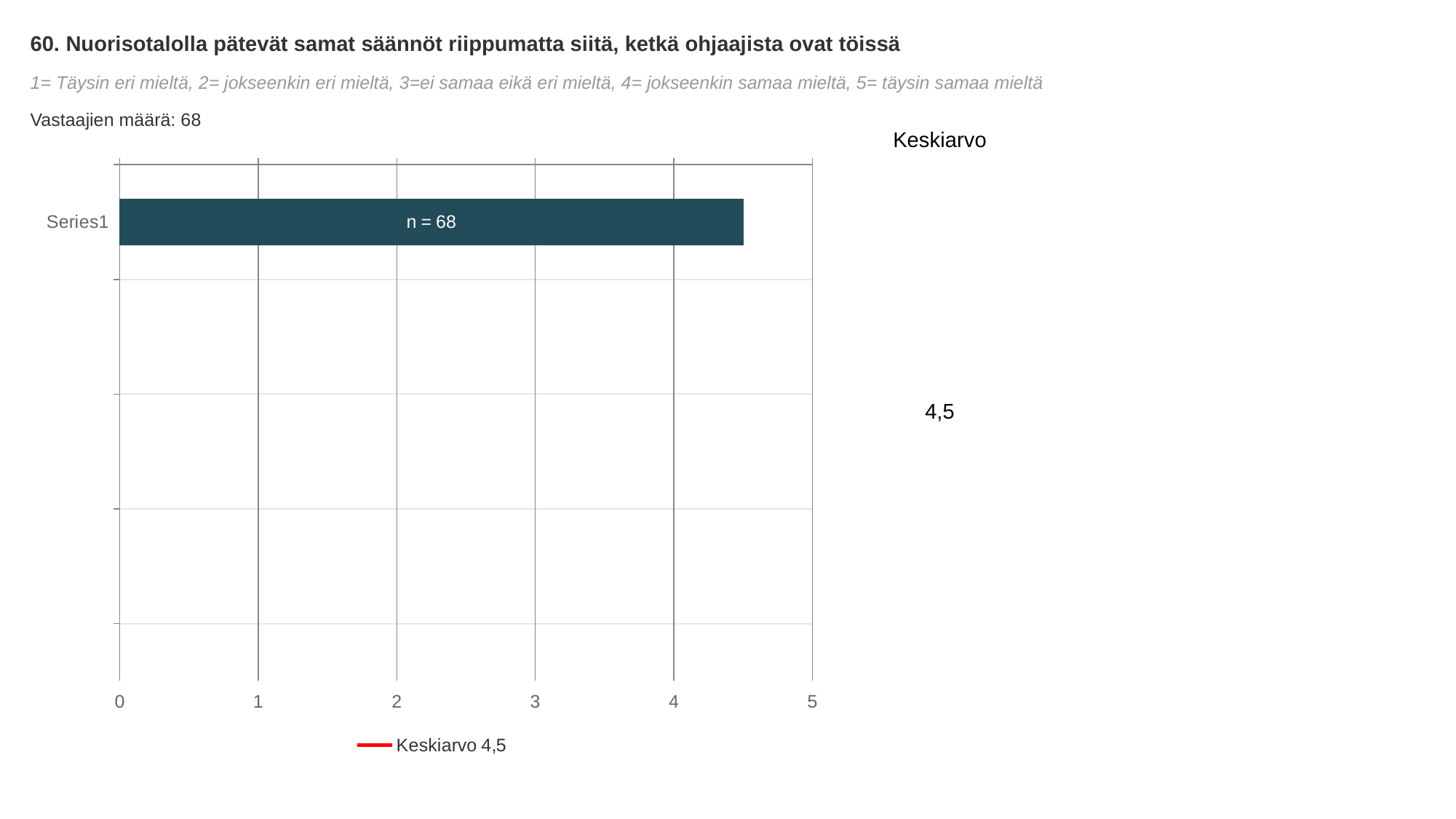
Is the value of the Series1 bar greater or less than 4? greater What is the Keskiarvo (mean) value shown for Series1? 4,5 What is the highest value shown on the horizontal axis? 5 What is the number of respondents (Vastaajien määrä) stated on the slide? 68 How many bars are plotted in the chart? 1 What data label is printed on the Series1 bar? n = 68 What kind of chart is shown on the slide? bar chart Is the value of the Series1 bar greater or less than 5? less What does the legend entry below the chart say? Keskiarvo 4,5